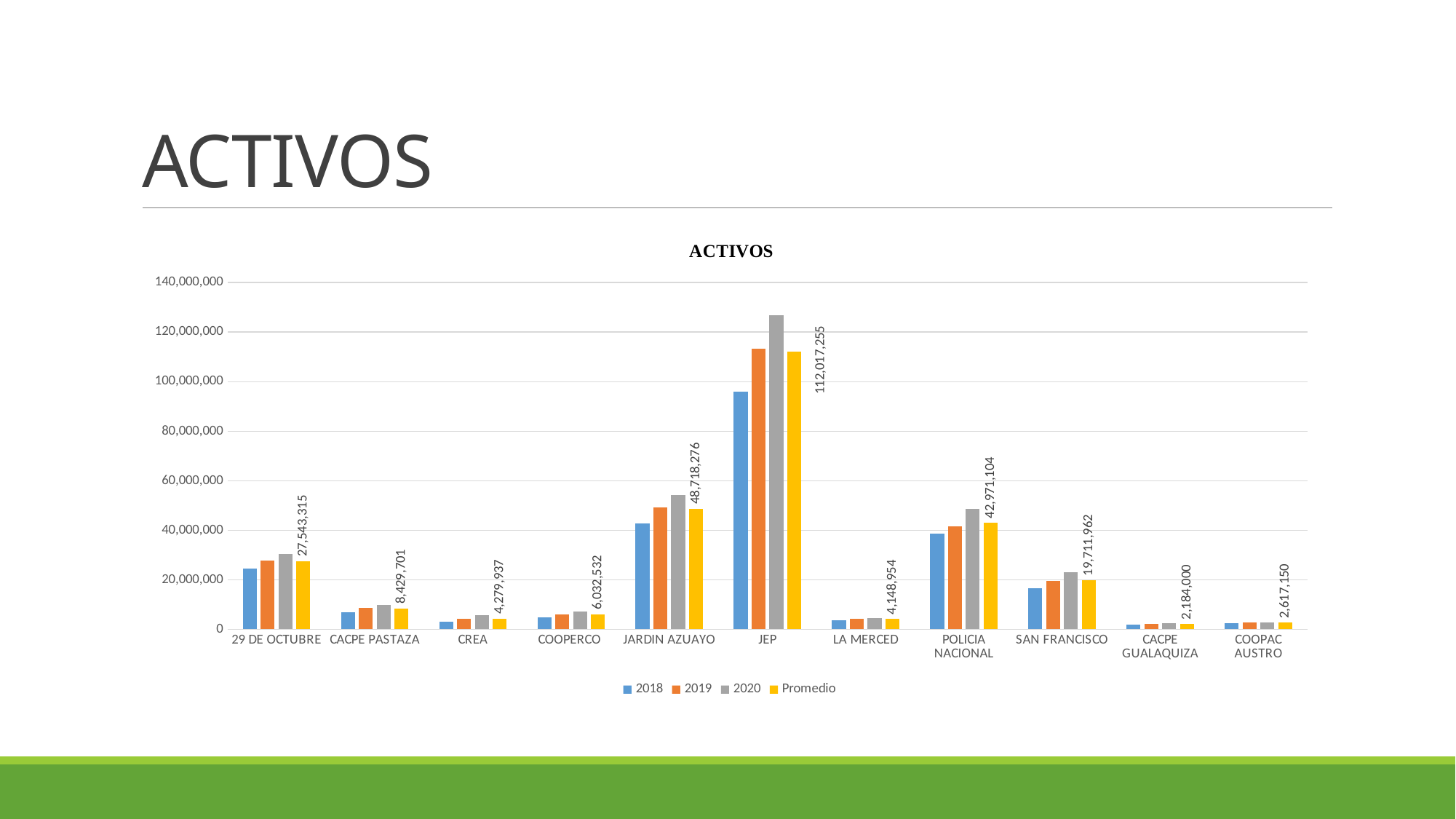
Is the 2018 value for JEP greater or less than 100,000,000? less What is the difference between the Promedio values for JEP and JARDIN AZUAYO? 63,298,979 Which category has the lowest Promedio value? CACPE GUALAQUIZA What is the difference between the Promedio values for CACPE PASTAZA and CREA? 4,149,764 What is the Promedio value for JARDIN AZUAYO? 48,718,276 Which category has the highest Promedio value? JEP Is the 2020 value for JEP greater or less than 120,000,000? greater Which has the larger Promedio value, POLICIA NACIONAL or 29 DE OCTUBRE? POLICIA NACIONAL What is the Promedio value for SAN FRANCISCO? 19,711,962 How many categories are shown on the x axis? 11 What is the Promedio value for JEP? 112,017,255 How many series does the legend list? 4